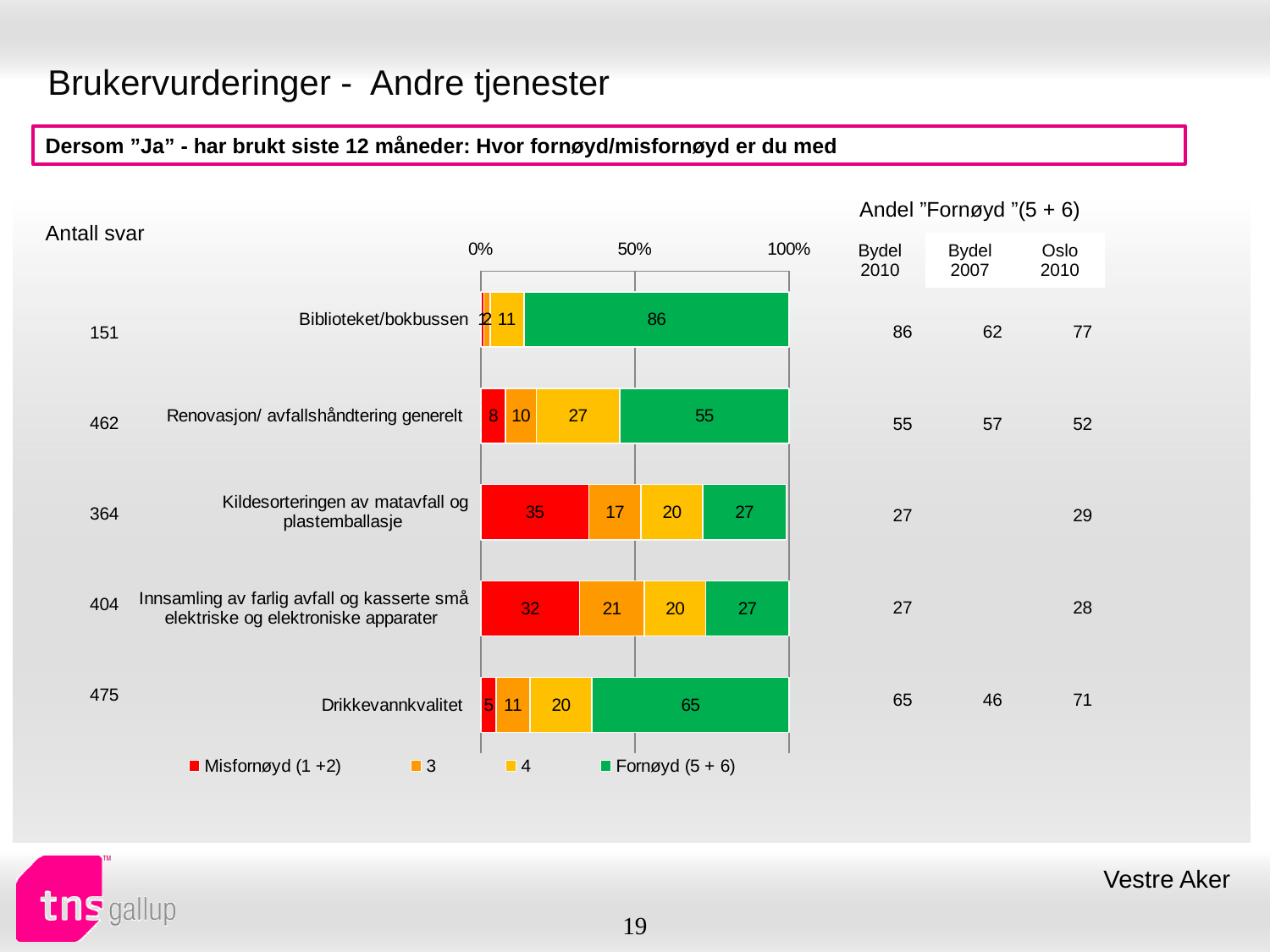
What kind of chart is shown on the slide? stacked bar chart Which category has the highest 'Fornøyd (5 + 6)' value? Biblioteket/bokbussen What is the difference between the 'Fornøyd (5 + 6)' values for Drikkevannkvalitet and Renovasjon/ avfallshåndtering generelt? 10 Which category has the lowest 'Misfornøyd (1 +2)' value among those with a printed label? Drikkevannkvalitet What is the value of series '3' for Innsamling av farlig avfall og kasserte små elektriske og elektroniske apparater? 21 How many series does the chart legend list? 4 What is the 'Fornøyd (5 + 6)' value for Biblioteket/bokbussen? 86 Is the 'Fornøyd (5 + 6)' value for Renovasjon/ avfallshåndtering generelt greater or less than 50%? greater Which has a larger 'Misfornøyd (1 +2)' value: Kildesorteringen av matavfall og plastemballasje or Renovasjon/ avfallshåndtering generelt? Kildesorteringen av matavfall og plastemballasje What is the value of series '4' for Drikkevannkvalitet? 20 What is the 'Misfornøyd (1 +2)' value for Kildesorteringen av matavfall og plastemballasje? 35 How many categories (services) are plotted in the chart? 5